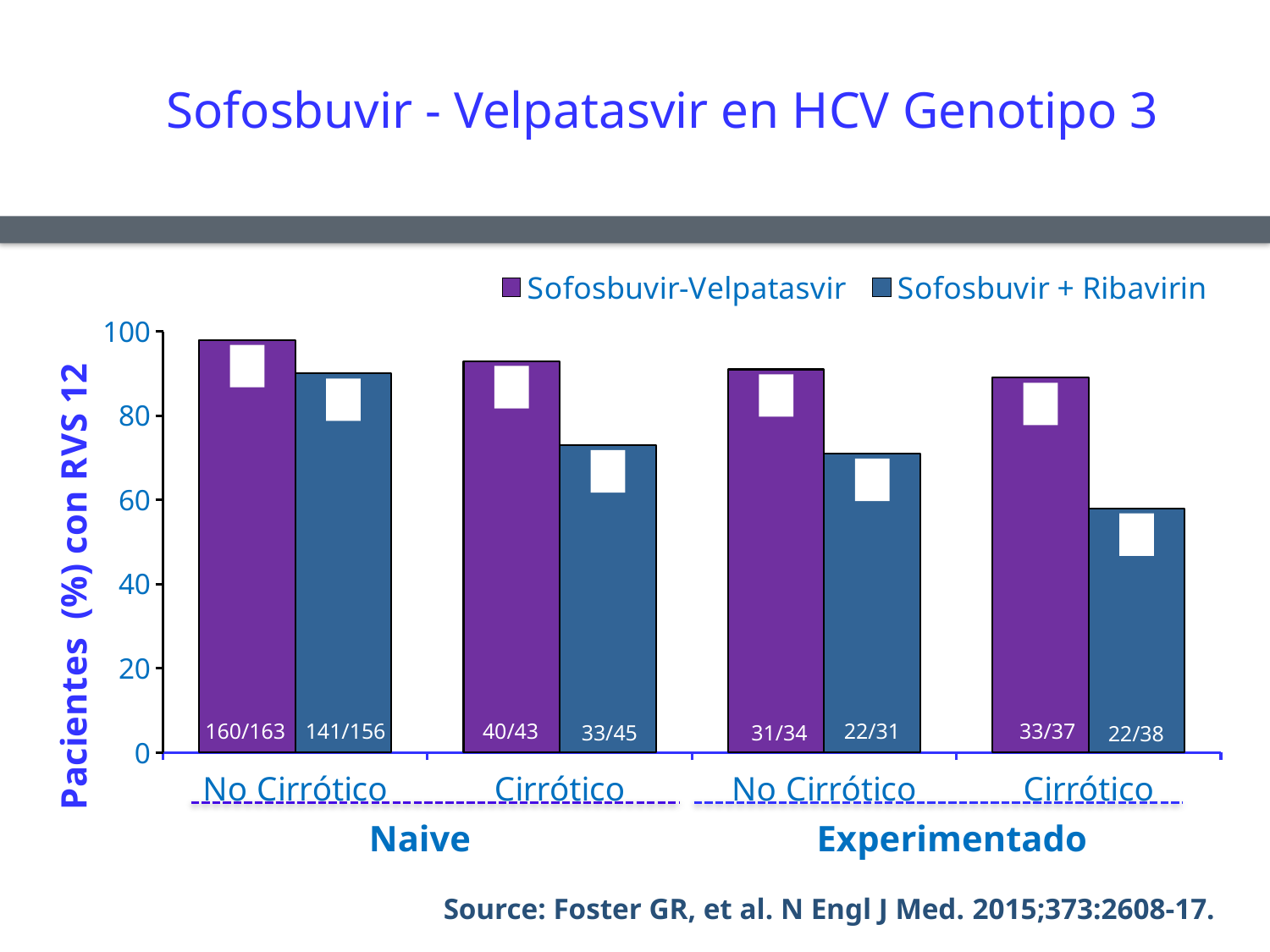
What kind of chart is shown on the slide? bar chart Is the Sofosbuvir + Ribavirin value for Naive Cirrótico patients greater or less than 80? less What is the title of the y axis? Pacientes (%) con RVS 12 Which category has the lowest Sofosbuvir + Ribavirin bar? Experimentado Cirrótico What label is printed on the Sofosbuvir + Ribavirin bar for Naive Cirrótico patients? 33/45 How many series does the legend list? 2 For Naive Cirrótico patients, which series has the higher bar? Sofosbuvir-Velpatasvir What label is printed on the Sofosbuvir + Ribavirin bar for Experimentado Cirrótico patients? 22/38 Is the Sofosbuvir + Ribavirin value for Experimentado Cirrótico patients greater or less than 40? greater Is the Sofosbuvir-Velpatasvir value for Naive No Cirrótico patients greater or less than 80? greater What label is printed on the Sofosbuvir-Velpatasvir bar for Naive No Cirrótico patients? 160/163 How many patient categories are shown along the x axis? 4